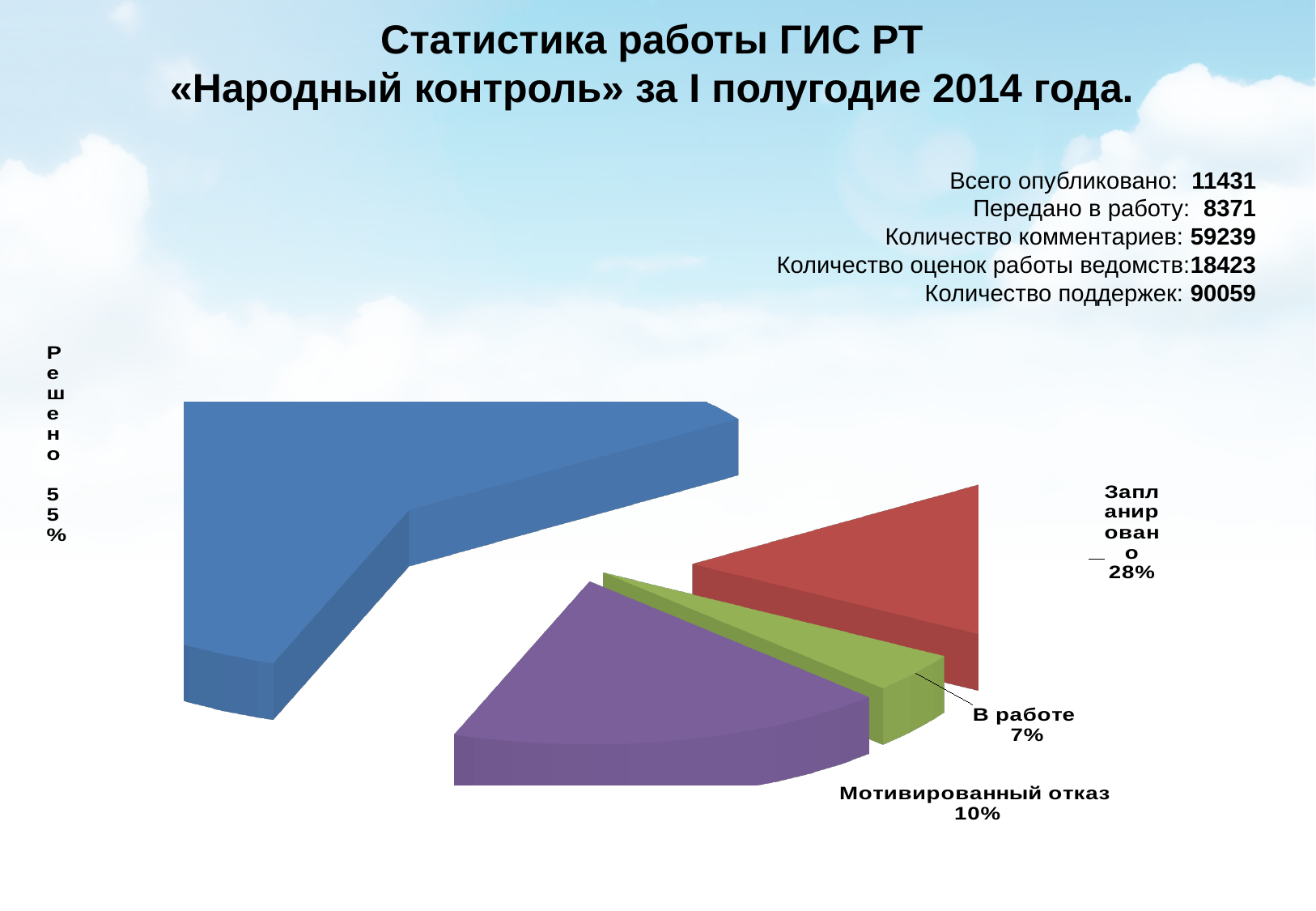
What is the difference in percentage points between the "Решено" and "Запланировано" slices? 27 What colour is the "Решено" slice of the pie chart? Blue Which is larger, the "Мотивированный отказ" slice or the "В работе" slice? Мотивированный отказ What share of the pie does the "Запланировано" slice represent? 28% What colour is the "Запланировано" slice of the pie chart? Red Which slice of the pie chart is the smallest? В работе Which slice of the pie chart is the largest? Решено How many slices does the pie chart have? 4 What kind of chart is shown on the slide? Pie chart What share of the pie does the "В работе" slice represent? 7% What share of the pie does the "Мотивированный отказ" slice represent? 10%